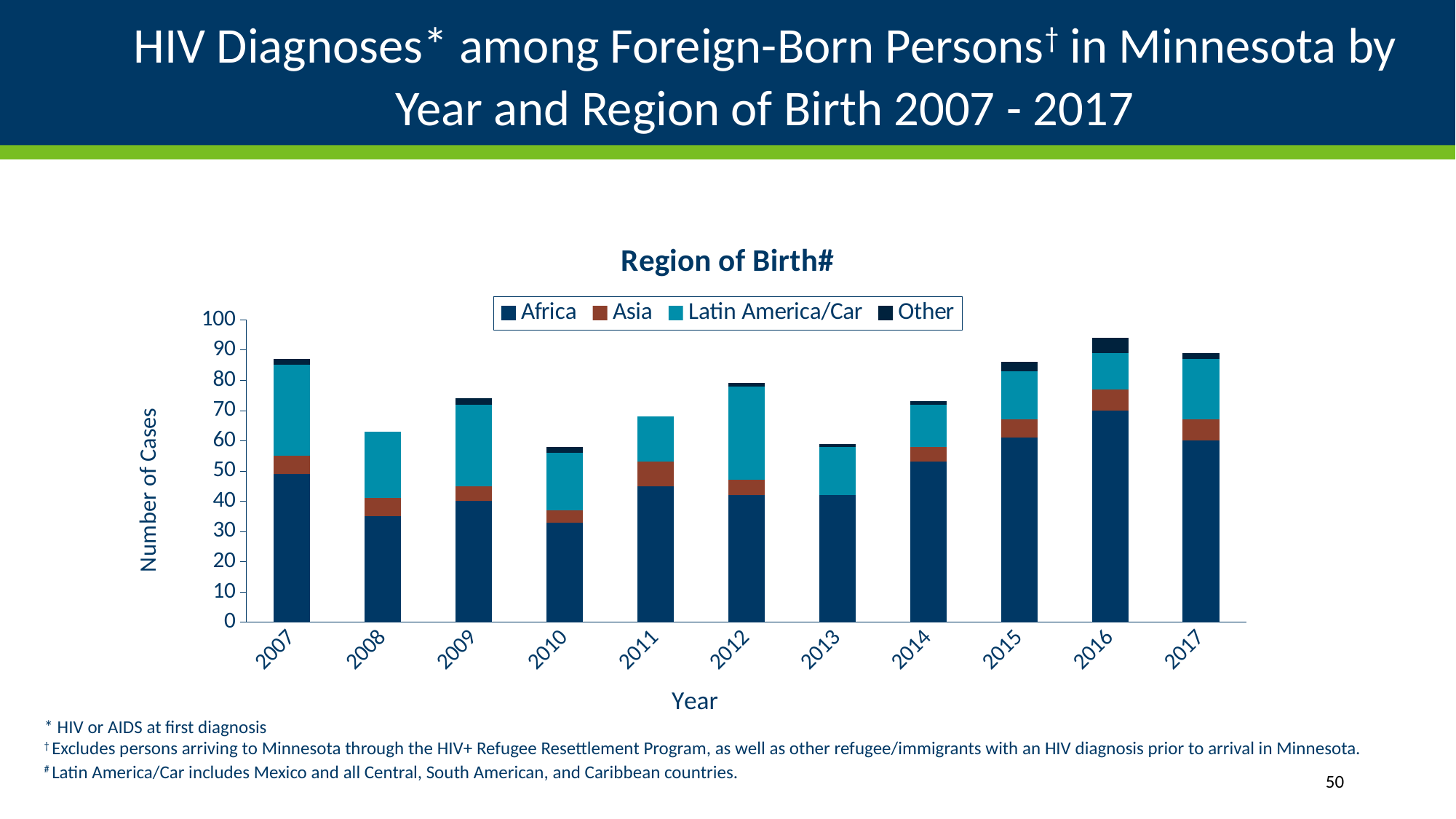
Is the total number of cases for 2015 greater or less than 80? greater How many series does the legend list? 4 Which year has the largest Africa segment? 2016 Which year has the highest total number of cases? 2016 What is the title of the y axis? Number of Cases Which regions of birth are listed in the legend? Africa, Asia, Latin America/Car, Other Is the total number of cases for 2016 greater or less than 90? greater How many years are shown along the x axis? 11 Which year has a higher total number of cases, 2007 or 2010? 2007 Is the Africa value for 2016 greater or less than 60? greater What kind of chart is shown on the slide? Stacked bar chart